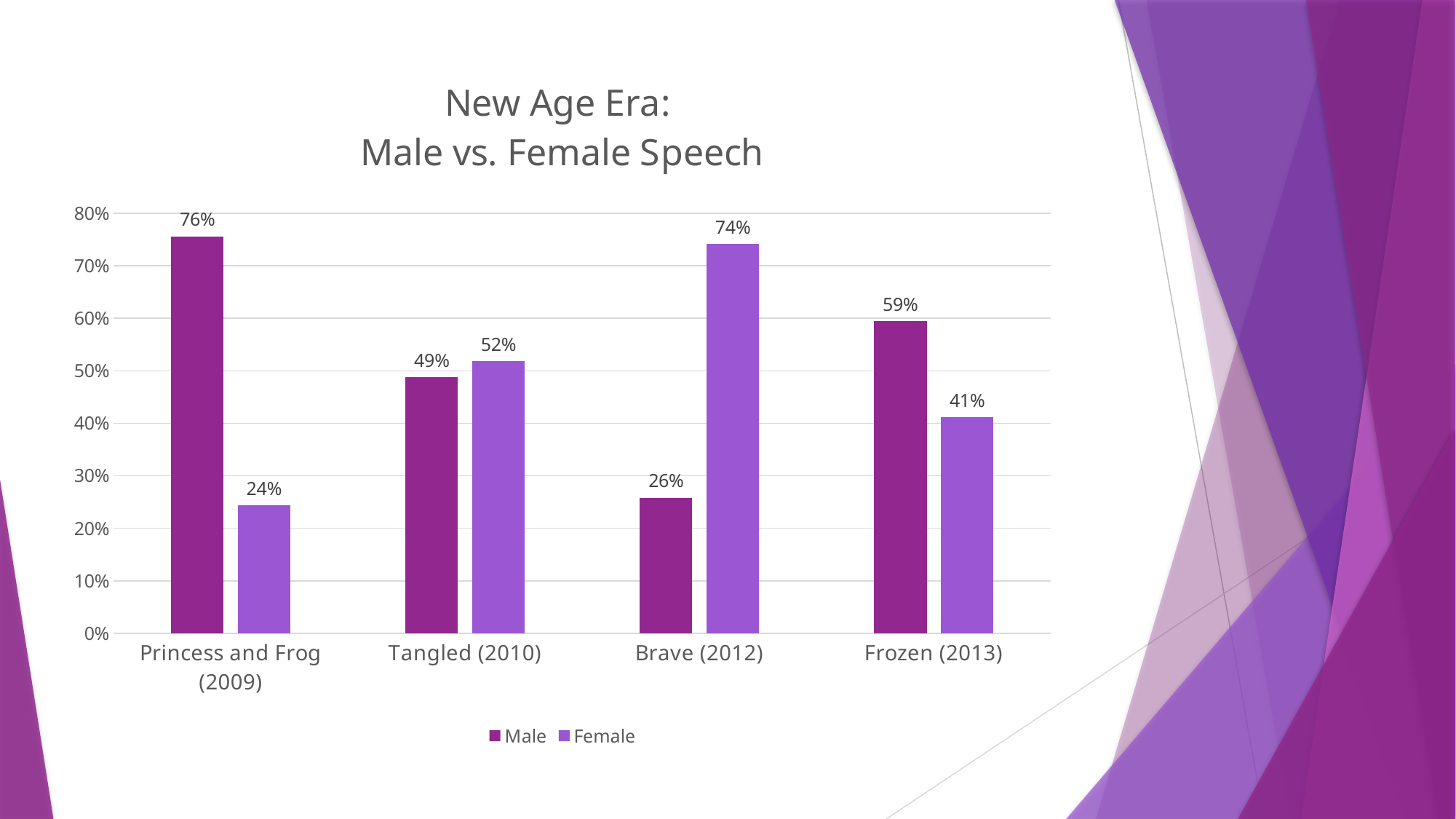
What kind of chart is shown on the slide? Bar chart What is the Female speech value for Frozen (2013)? 41% What is the difference between the Male and Female speech values for Frozen (2013)? 18% What is the title of the chart? New Age Era: Male vs. Female Speech Which film has the lowest Female speech value? Princess and Frog (2009) Which film has the highest Male speech value? Princess and Frog (2009) How many films are shown on the x axis? 4 Is the Male speech value for Brave (2012) greater or less than 30%? less What is the Female speech value for Brave (2012)? 74% For Tangled (2010), which is larger, the Male or the Female speech value? Female How many series does the legend list? 2 What is the Male speech value for Princess and Frog (2009)? 76%